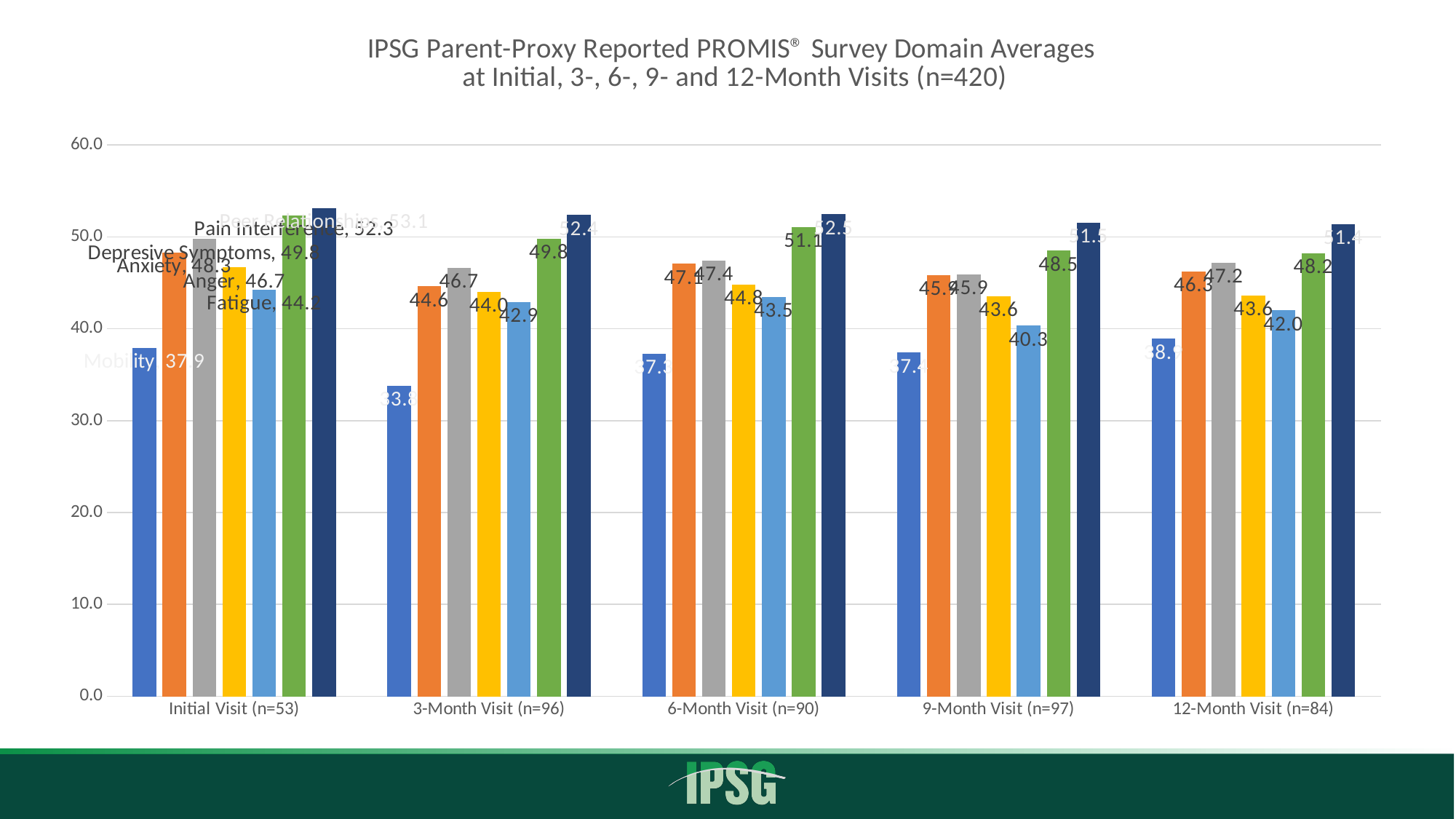
What is the Mobility value at the Initial Visit? 37.9 What type of chart is shown on the slide? bar chart Which domain has the lowest value at the Initial Visit? Mobility Which domain has the highest value at the Initial Visit? Peer Relationships What is the difference between the Anxiety and Anger values at the Initial Visit? 1.6 Is the Mobility value at the 3-Month Visit greater or less than 40.0? less How many visit categories are shown on the x axis? 5 What is the Peer Relationships value at the Initial Visit? 53.1 What is the Pain Interference value at the Initial Visit? 52.3 Which is larger at the Initial Visit: Depressive Symptoms or Anxiety? Depressive Symptoms What is the title of the chart? IPSG Parent-Proxy Reported PROMIS® Survey Domain Averages at Initial, 3-, 6-, 9- and 12-Month Visits (n=420) What is the Fatigue value at the Initial Visit? 44.2